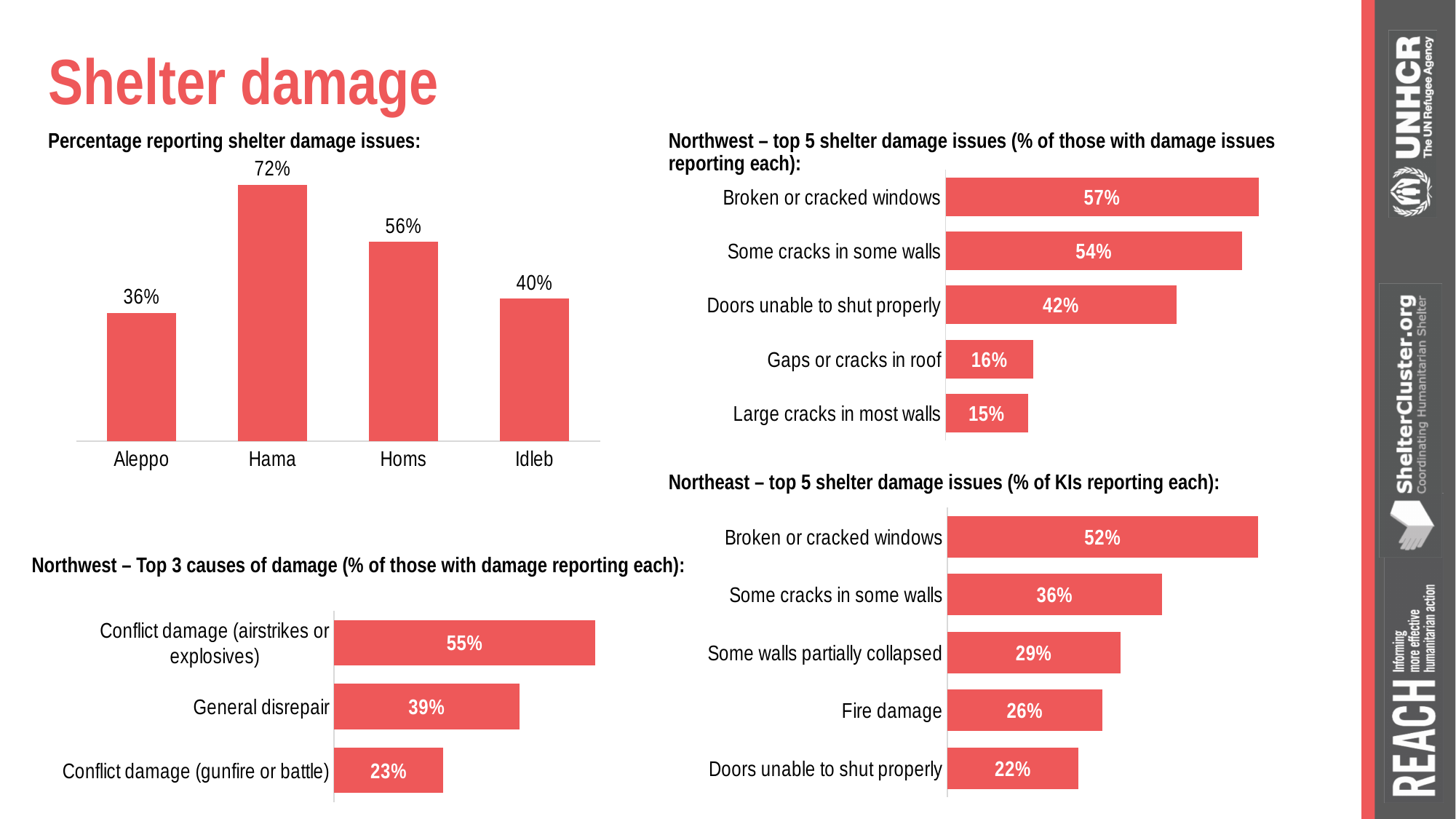
In the 'Percentage reporting shelter damage issues' chart, how many governorates are shown? 4 In the 'Northwest – Top 3 causes of damage' chart, which cause has the lowest value? Conflict damage (gunfire or battle) In the 'Northwest – top 5 shelter damage issues' chart, what is the difference between 'Gaps or cracks in roof' and 'Large cracks in most walls'? 1% In the 'Percentage reporting shelter damage issues' chart, which governorate has the lowest value? Aleppo In the 'Percentage reporting shelter damage issues' chart, what is the difference between Hama and Idleb? 32% In the 'Northeast – top 5 shelter damage issues' chart, what is the value for 'Fire damage'? 26% In the 'Northeast – top 5 shelter damage issues' chart, which is larger: 'Some walls partially collapsed' or 'Doors unable to shut properly'? Some walls partially collapsed What kind of chart is the 'Percentage reporting shelter damage issues' chart? Bar chart In the 'Northwest – top 5 shelter damage issues' chart, what is the value for 'Doors unable to shut properly'? 42% In the 'Northwest – top 5 shelter damage issues' chart, which issue has the highest value? Broken or cracked windows In the 'Percentage reporting shelter damage issues' chart, what is the value for Hama? 72% In the 'Northwest – Top 3 causes of damage' chart, what is the value for 'General disrepair'? 39%